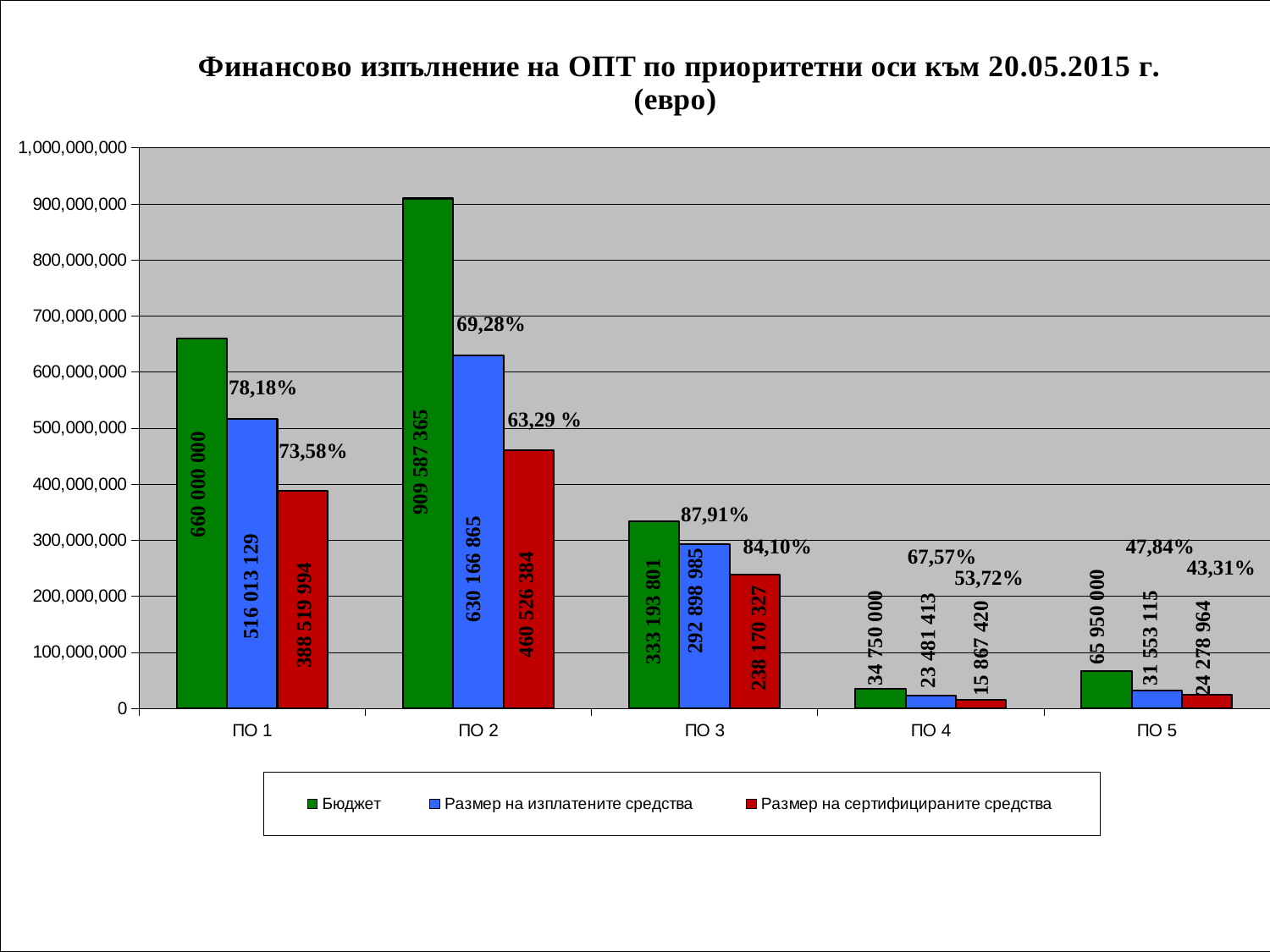
Which category has the highest Бюджет value? ПО 2 What is the Бюджет value for ПО 2? 909 587 365 Which category has the lowest Размер на сертифицираните средства value? ПО 4 What is the value of Размер на изплатените средства for ПО 3? 292 898 985 What percentage is shown above the Размер на изплатените средства bar for ПО 4? 67,57% What is the value of Размер на сертифицираните средства for ПО 5? 24 278 964 What type of chart is shown on the slide? bar chart Which series is shown in red in the legend? Размер на сертифицираните средства How many series does the legend list? 3 Which is larger: the Бюджет value for ПО 4 or the Бюджет value for ПО 5? ПО 5 What is the difference between the Бюджет and Размер на изплатените средства values for ПО 1? 143 986 871 How many categories (priority axes) are shown on the x axis? 5